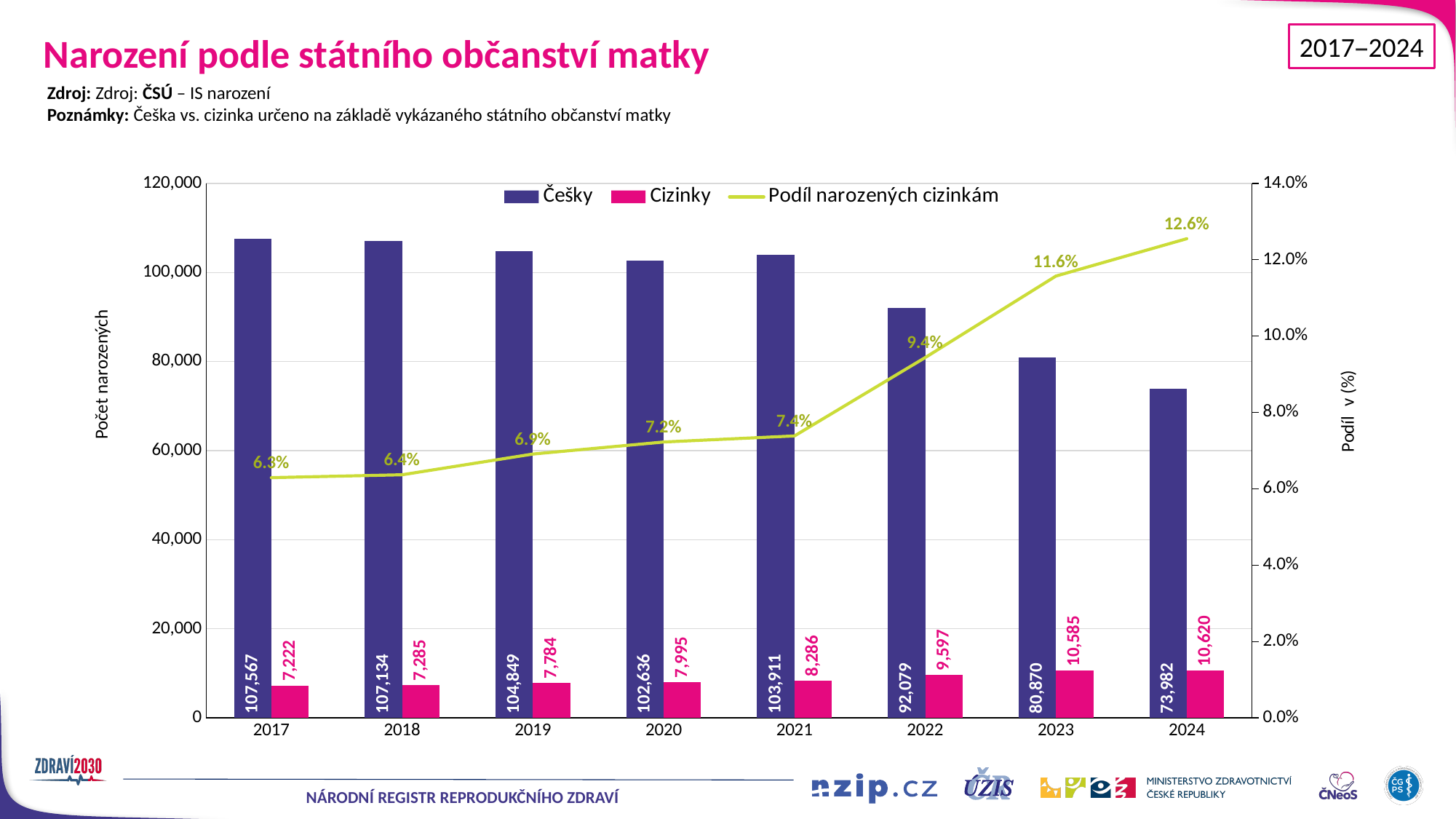
What is the value of Podíl narozených cizinkám in 2022? 9.4% What is the title of the slide's chart? Narození podle státního občanství matky Is the Češky value in 2023 greater or less than 100,000? less What is the difference between the Češky values in 2017 and 2024? 33,585 In which year is the Češky value lowest? 2024 In which year is the Cizinky value highest? 2024 How many years are shown on the x axis? 8 What is the value for Češky in 2017? 107,567 What is the value for Cizinky in 2024? 10,620 Which is larger: the Cizinky value in 2021 or in 2022? 2022 How many series does the legend list? 3 Does the Podíl narozených cizinkám line rise or fall from 2017 to 2024? rise